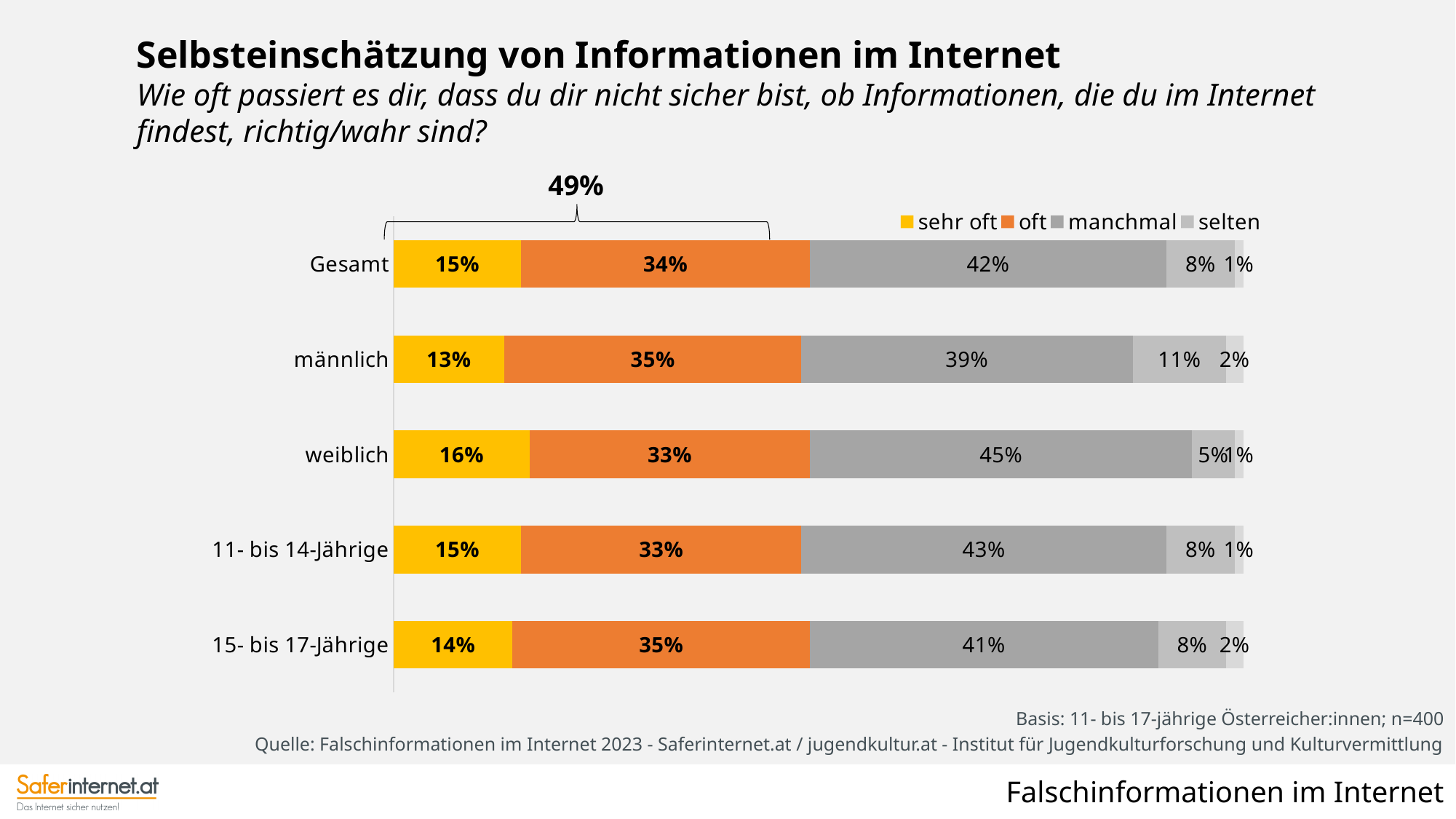
What is the 'selten' value for männlich? 11% What is the 'oft' value for 15- bis 17-Jährige? 35% Which category has the highest 'manchmal' value? weiblich Which category has the lowest 'sehr oft' value? männlich What is the 'manchmal' value for weiblich? 45% What is the difference between the 'manchmal' values for weiblich and männlich? 6% How many series does the legend list? 4 What combined percentage is shown by the bracket above the Gesamt bar for 'sehr oft' and 'oft'? 49% What kind of chart is shown on the slide? stacked bar chart What is the 'sehr oft' value for Gesamt? 15% Which is larger: the 'oft' value for männlich or the 'oft' value for weiblich? männlich How many categories (rows) are plotted in the chart? 5